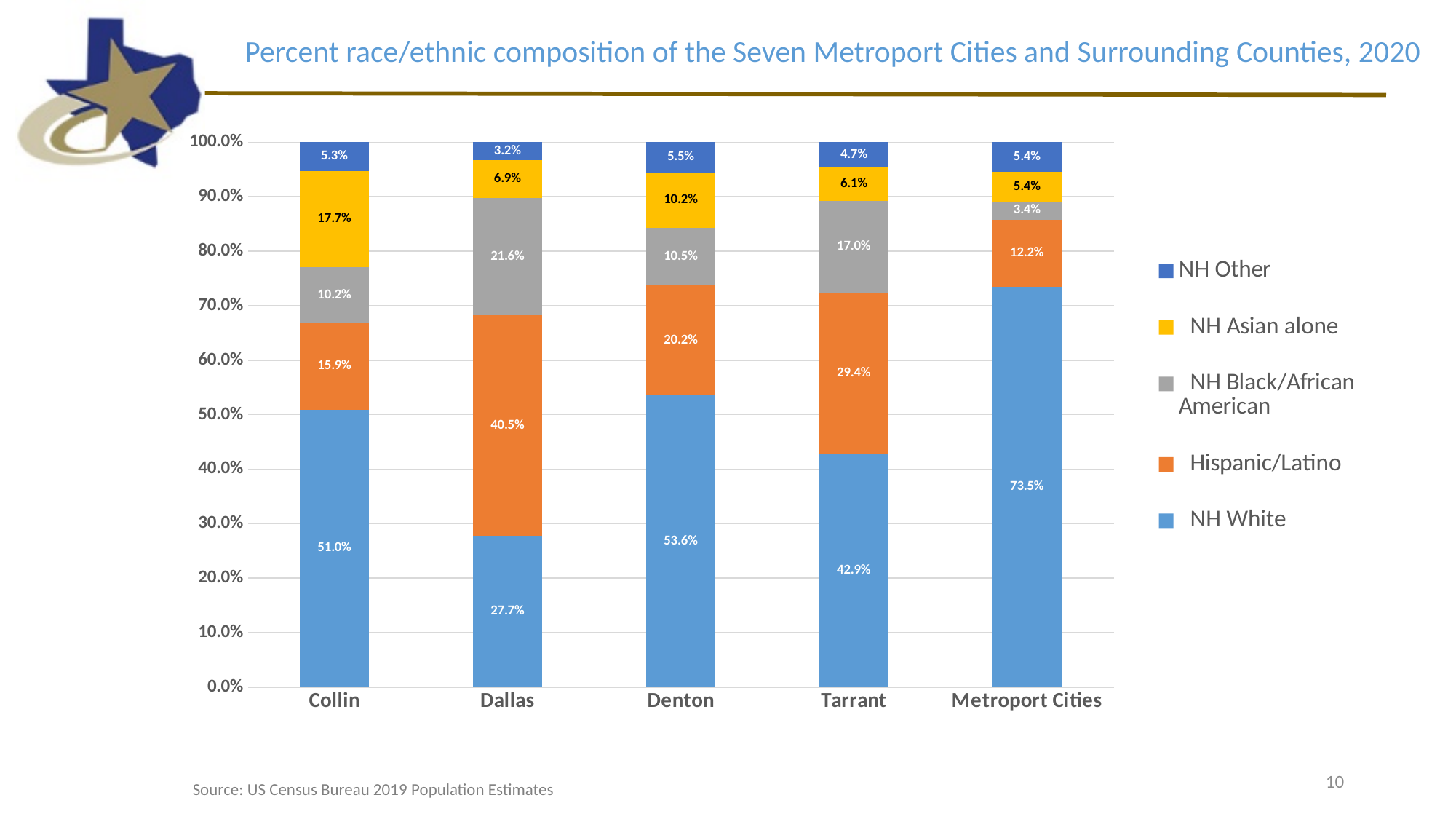
What is the Hispanic/Latino percentage for Dallas? 40.5% What is the difference between the Hispanic/Latino percentages for Tarrant and Denton? 9.2% What kind of chart is shown on the slide? Stacked bar chart How many series does the legend list? 5 How many categories are shown on the x axis? 5 What is the difference between the NH White percentages for Denton and Collin? 2.6% Which category has the lowest NH White percentage? Dallas What is the NH White percentage for Metroport Cities? 73.5% What is the NH Asian alone percentage for Collin? 17.7% Which has a larger NH Black/African American percentage, Dallas or Tarrant? Dallas Which category has the highest NH White percentage? Metroport Cities Which category has the lowest NH Black/African American percentage? Metroport Cities